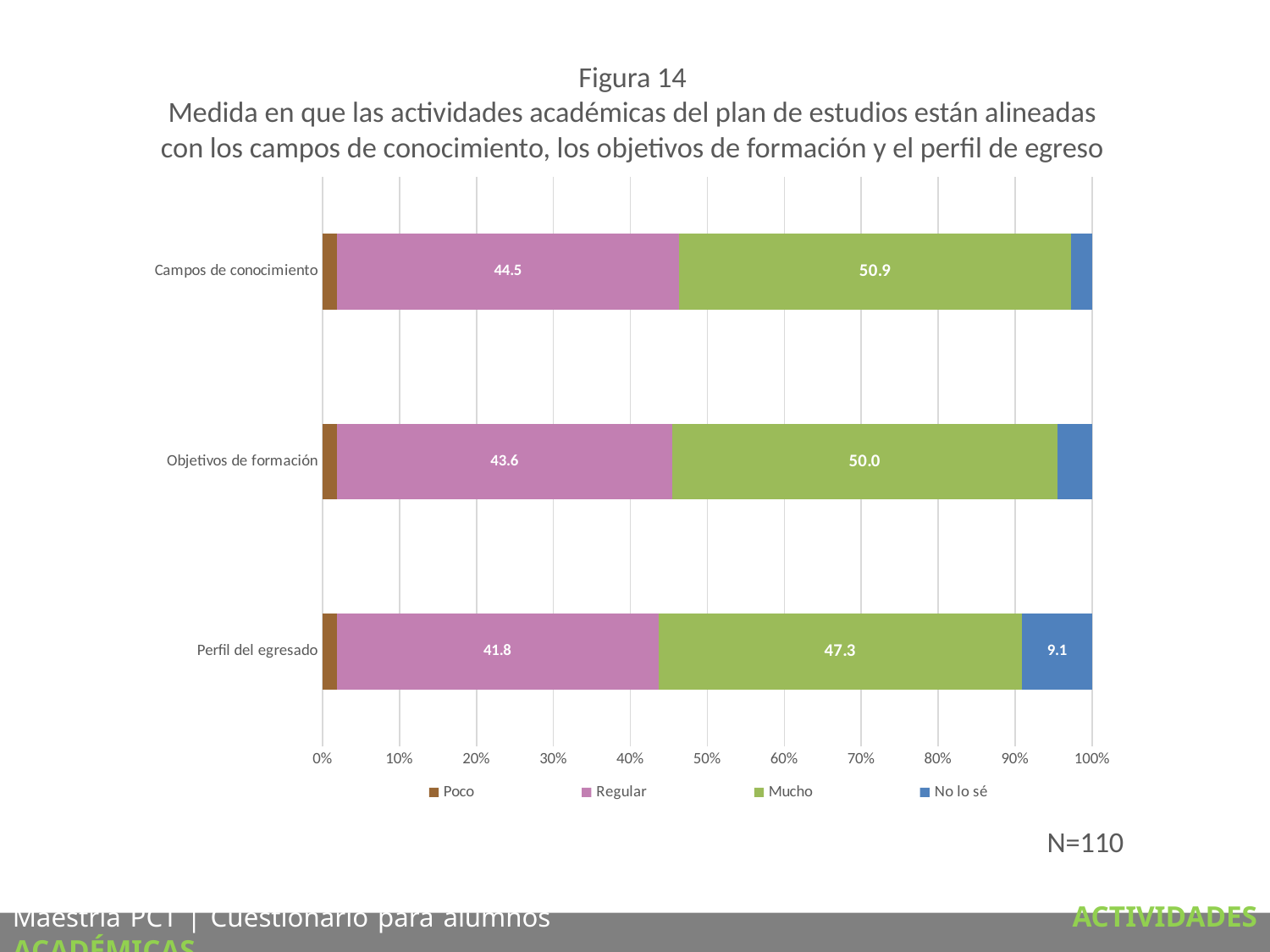
Which category has the lowest 'Regular' value? Perfil del egresado What is the value of the 'Regular' segment for 'Objetivos de formación'? 43.6 What is the difference between the 'Mucho' values for 'Campos de conocimiento' and 'Perfil del egresado'? 3.6 What type of chart is shown on the slide? Stacked bar chart Is the 'Poco' value for 'Objetivos de formación' greater or less than 10%? less Which is larger: the 'Regular' value for 'Campos de conocimiento' or the 'Regular' value for 'Perfil del egresado'? Campos de conocimiento What is the value of the 'Mucho' segment for 'Campos de conocimiento'? 50.9 How many series does the legend list? 4 Which legend entry is shown in blue? No lo sé How many categories are shown on the vertical axis of the chart? 3 What is the value of the 'No lo sé' segment for 'Perfil del egresado'? 9.1 Which category has the highest 'Mucho' value? Campos de conocimiento